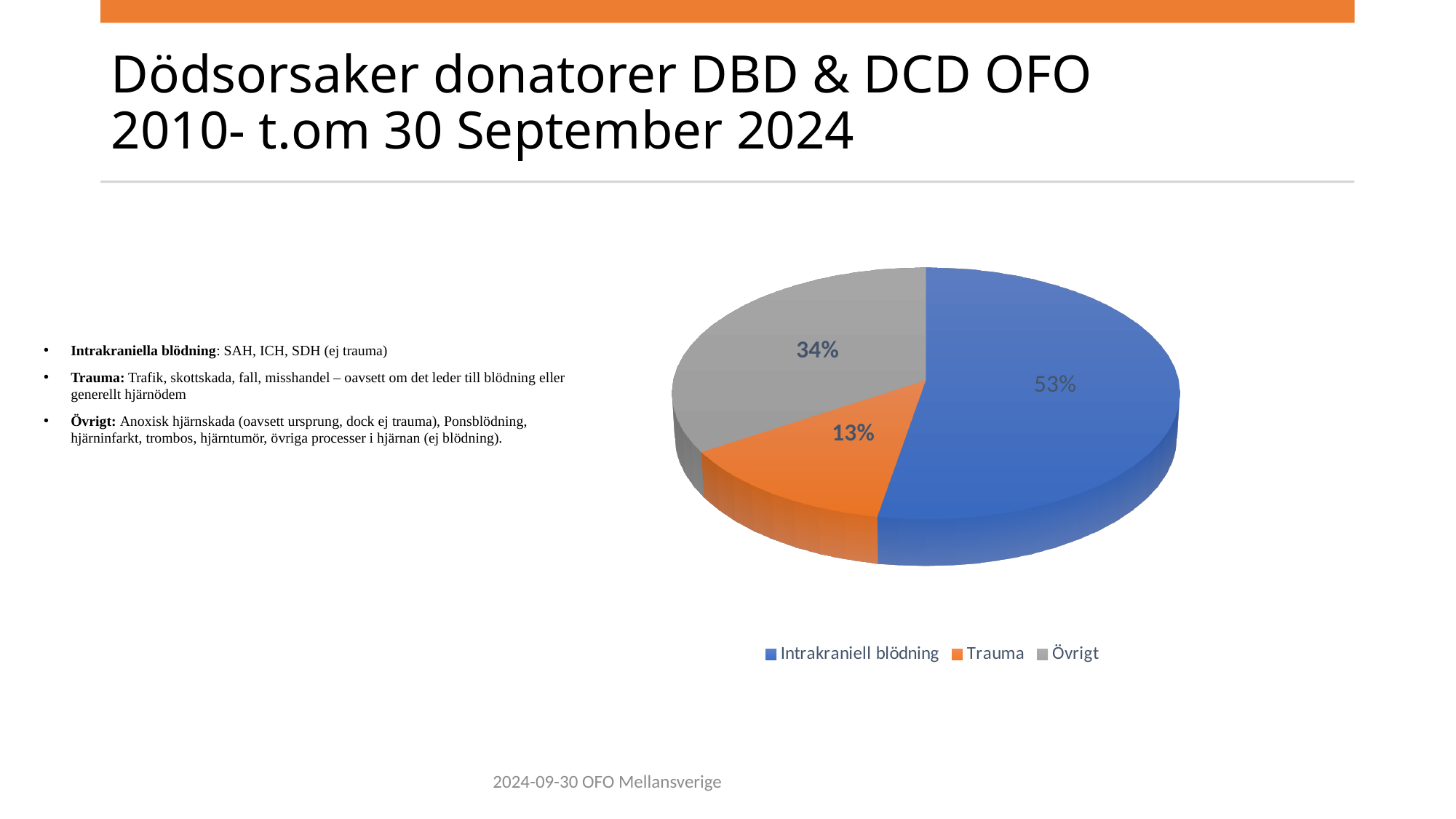
What share of the pie does Trauma represent? 13% What kind of chart is shown on the slide? Pie chart What share of the pie does Övrigt represent? 34% Which category has the smallest slice of the pie? Trauma Which category has the largest slice of the pie? Intrakraniell blödning What is the difference in percentage points between Övrigt and Trauma? 21 Which is larger, the share for Övrigt or the share for Trauma? Övrigt What colour is the Trauma slice in the pie chart? Orange What is the difference in percentage points between Intrakraniell blödning and Övrigt? 19 What are the three legend entries of the pie chart? Intrakraniell blödning, Trauma, Övrigt What share of the pie does Intrakraniell blödning represent? 53% How many categories are shown in the pie chart? 3